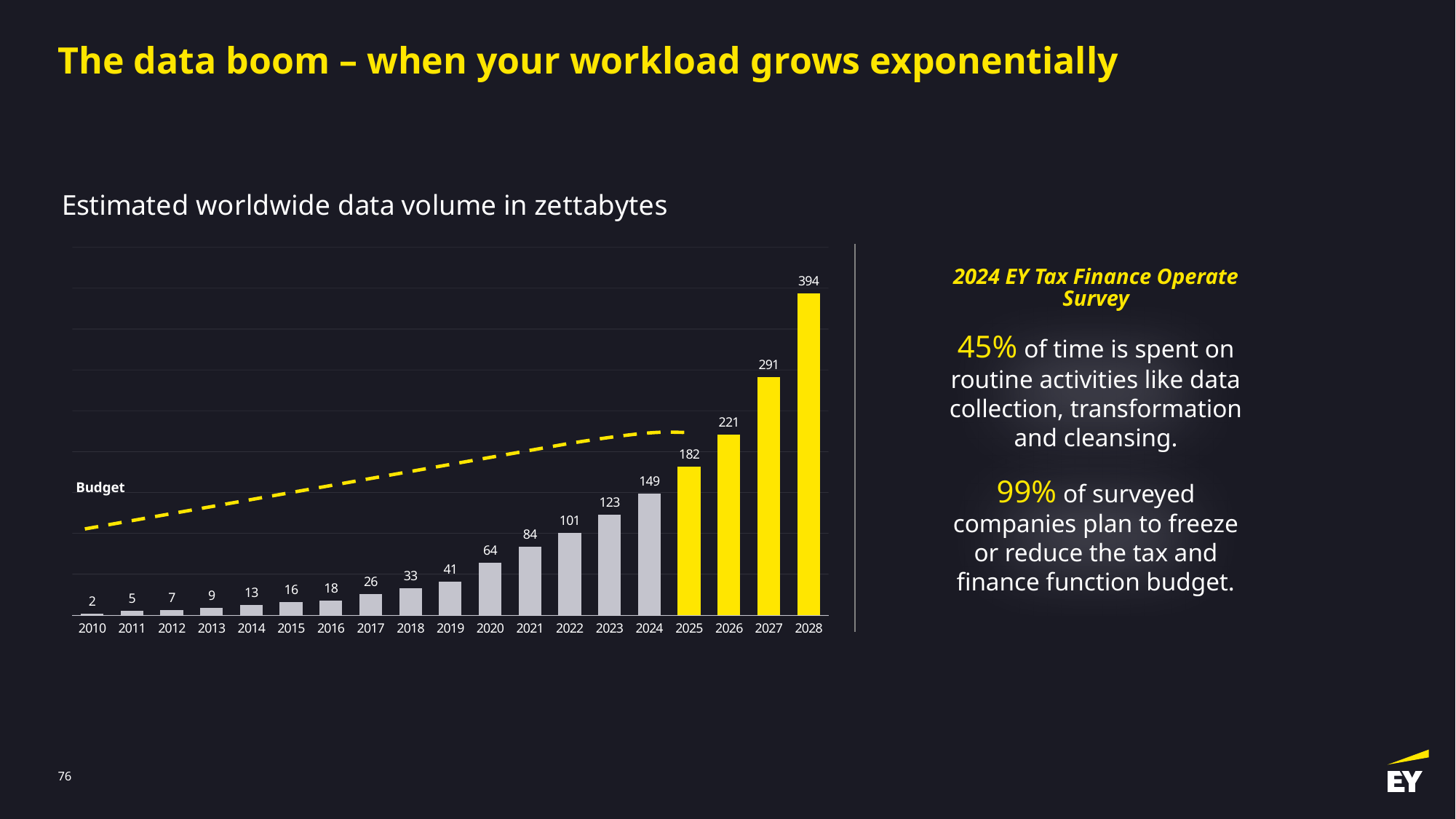
How many years are shown on the x axis of the chart? 19 What does the dashed yellow line on the chart represent? Budget What is the estimated worldwide data volume in zettabytes for 2020? 64 What is the difference in zettabytes between the 2028 and 2027 values? 103 What is the estimated worldwide data volume in zettabytes for 2028? 394 What is the estimated worldwide data volume in zettabytes for 2010? 2 Which year has the lowest estimated worldwide data volume? 2010 What kind of chart is used to show the estimated worldwide data volume? Bar chart Which year has the highest estimated worldwide data volume? 2028 Do the estimated data volume values rise or fall from 2010 to 2028? Rise Which year has a larger estimated data volume, 2022 or 2023? 2023 What is the estimated worldwide data volume in zettabytes for 2024? 149